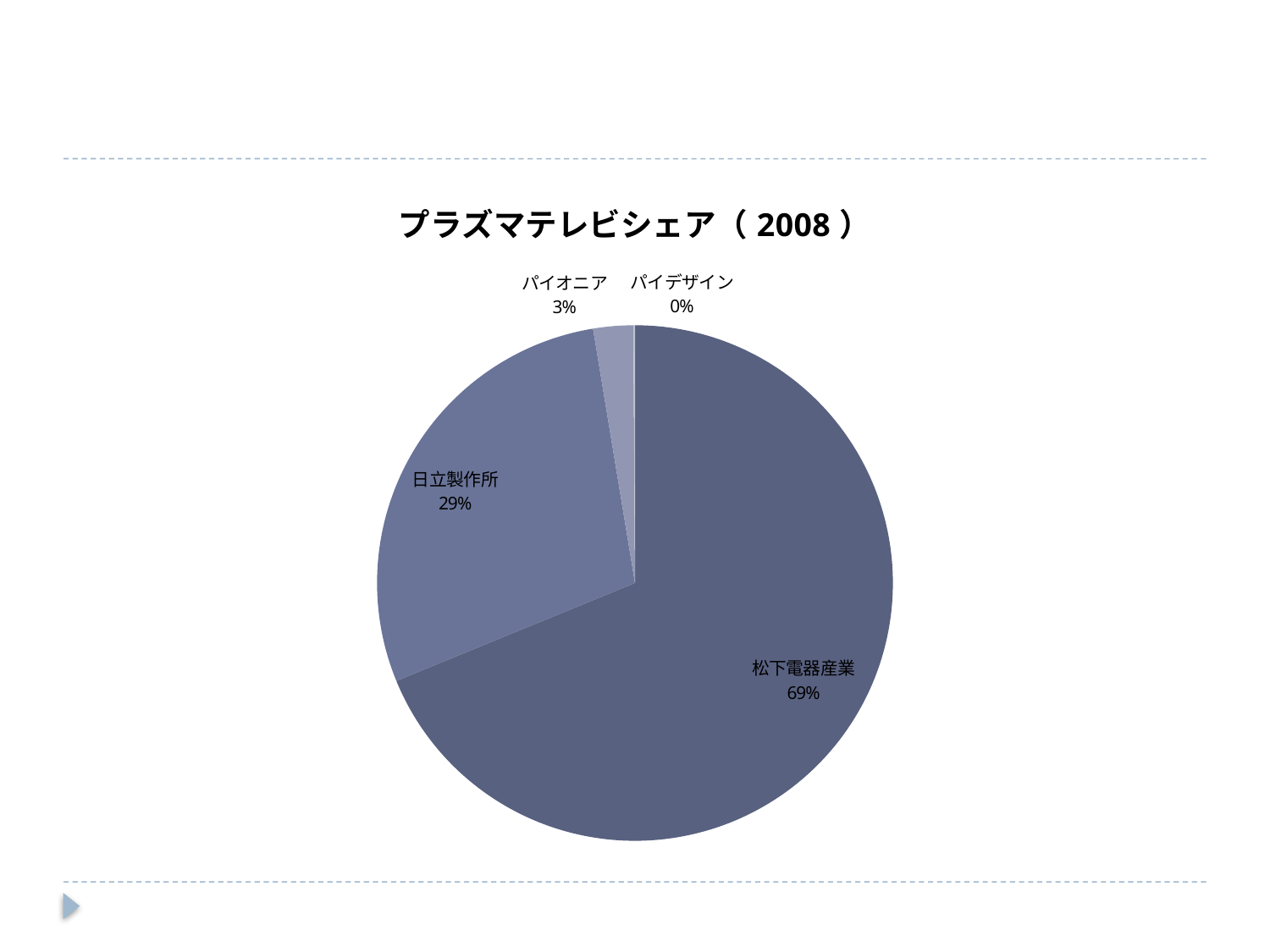
Which company has the smallest share of the pie? パイデザイン What share does 日立製作所 have in the pie chart? 29% Which company has the largest share of the pie? 松下電器産業 What share does 松下電器産業 have in the pie chart? 69% Which has a larger share, 日立製作所 or パイオニア? 日立製作所 What share does パイオニア have in the pie chart? 3% What kind of chart is shown on the slide? pie chart What is the difference in share between 松下電器産業 and 日立製作所? 40 percentage points What is the title of the chart? プラズマテレビシェア（2008） What share is shown for パイデザイン? 0% What is the combined share of 日立製作所 and パイオニア? 32% How many slices (categories) are labelled in the pie chart? 4